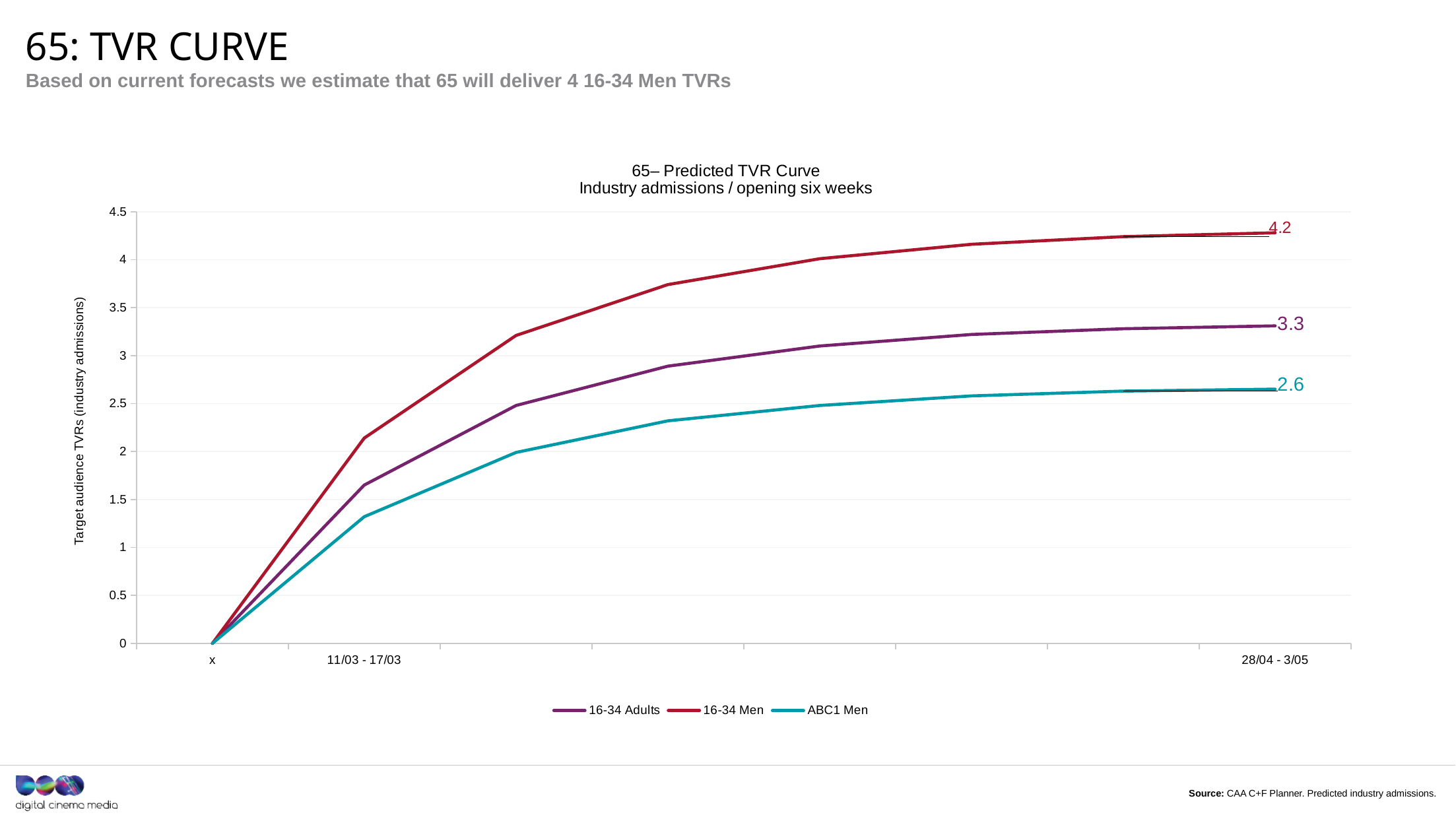
What is the difference between the final values for 16-34 Men and 16-34 Adults? 0.9 Which series has the lowest value at the end of the curve? ABC1 Men What kind of chart is shown on the slide? line chart What is the difference between the final values for 16-34 Men and ABC1 Men? 1.6 Is the value for ABC1 Men at 11/03 - 17/03 greater or less than 1.5? less Do the values rise or fall along the x axis? rise What is the final value for ABC1 Men at 28/04 - 3/05? 2.6 Which series reaches the highest value at the end of the curve? 16-34 Men How many series does the legend list? 3 What is the final value for 16-34 Men at 28/04 - 3/05? 4.2 Which is larger at 28/04 - 3/05, the value for 16-34 Adults or for ABC1 Men? 16-34 Adults What is the final value for 16-34 Adults at 28/04 - 3/05? 3.3